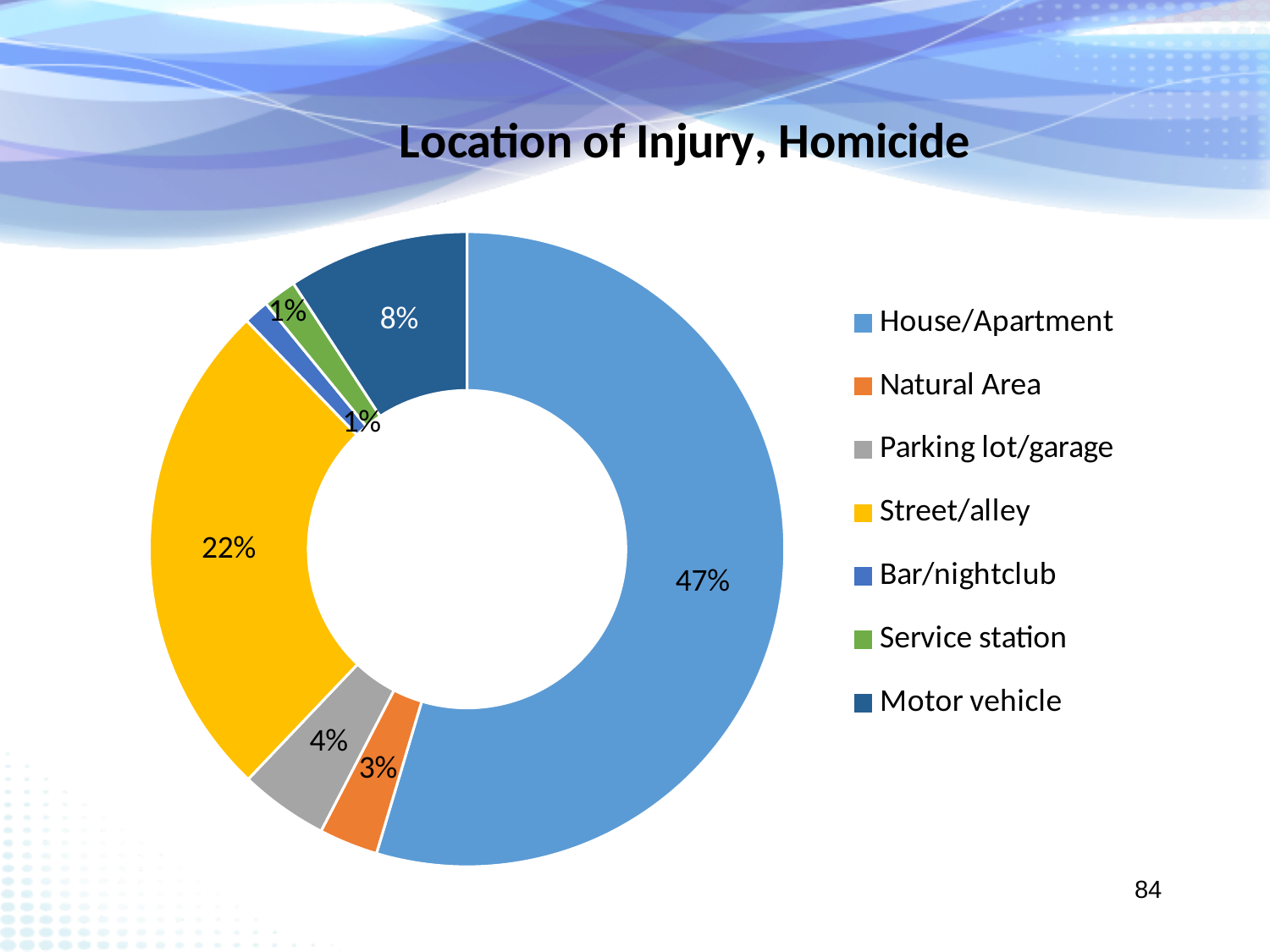
What kind of chart is shown on the slide? Doughnut chart How many location categories does the legend list? 7 Which has a larger share, Motor vehicle or Parking lot/garage? Motor vehicle What percentage of homicide injuries occurred on a Street/alley? 22% What percentage of homicide injuries occurred in a Parking lot/garage? 4% Which location accounts for the largest share of homicide injuries? House/Apartment What percentage of homicide injuries occurred in a Natural Area? 3% What percentage of homicide injuries occurred at a House/Apartment? 47% What is the difference in percentage points between House/Apartment and Street/alley? 25 What is the title of the chart? Location of Injury, Homicide What percentage of homicide injuries occurred in a Motor vehicle? 8% Which has a larger share, Natural Area or Street/alley? Street/alley